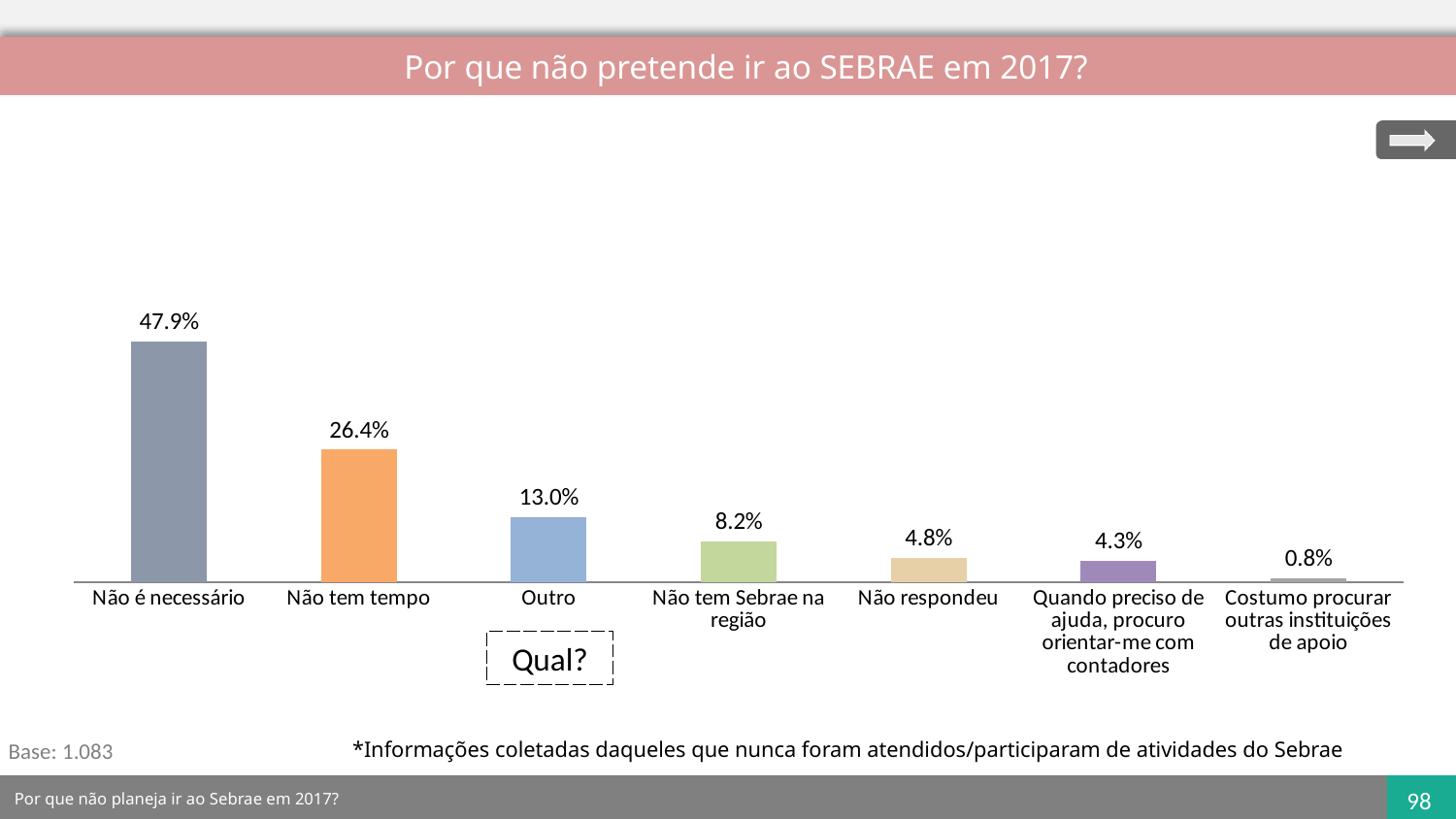
What kind of chart is shown on the slide? Bar chart Which is larger, the value for "Outro" or the value for "Não respondeu"? Outro Do the values rise or fall from left to right along the x axis? Fall What is the title of the slide? Por que não pretende ir ao SEBRAE em 2017? Which category has the highest value? Não é necessário Which category has the lowest value? Costumo procurar outras instituições de apoio What is the value for "Costumo procurar outras instituições de apoio"? 0.8% What is the difference between the values for "Não é necessário" and "Não tem tempo"? 21.5% What is the value for "Não é necessário"? 47.9% What is the value for "Não tem Sebrae na região"? 8.2% What is the value for "Não tem tempo"? 26.4% How many categories are shown in the chart? 7